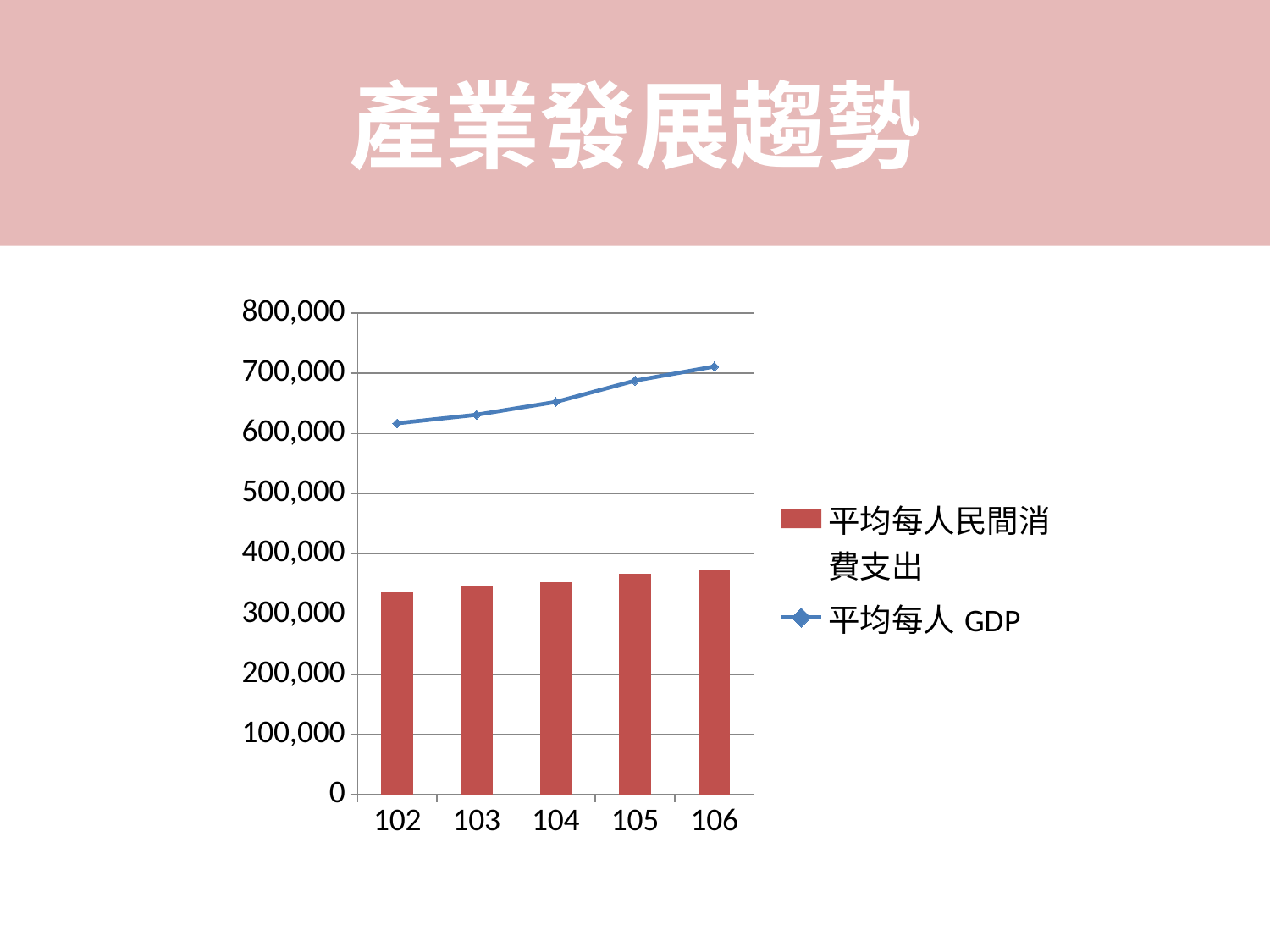
What is the title of the slide containing the chart? 產業發展趨勢 Which category has the lowest value for 平均每人 GDP? 102 Which category has the highest value for 平均每人 GDP? 106 Is the value for 平均每人 GDP at 106 greater or less than 700,000? greater Is the value for 平均每人民間消費支出 at 102 greater or less than 400,000? less Which is larger at 104: 平均每人 GDP or 平均每人民間消費支出? 平均每人 GDP Do the values for 平均每人 GDP rise or fall from 102 to 106? rise What kind of chart is used for the 平均每人 GDP series? line chart How many categories are shown on the x axis? 5 What kind of chart is used for the 平均每人民間消費支出 series? bar chart Which category has the lowest value for 平均每人民間消費支出? 102 How many series does the legend list? 2